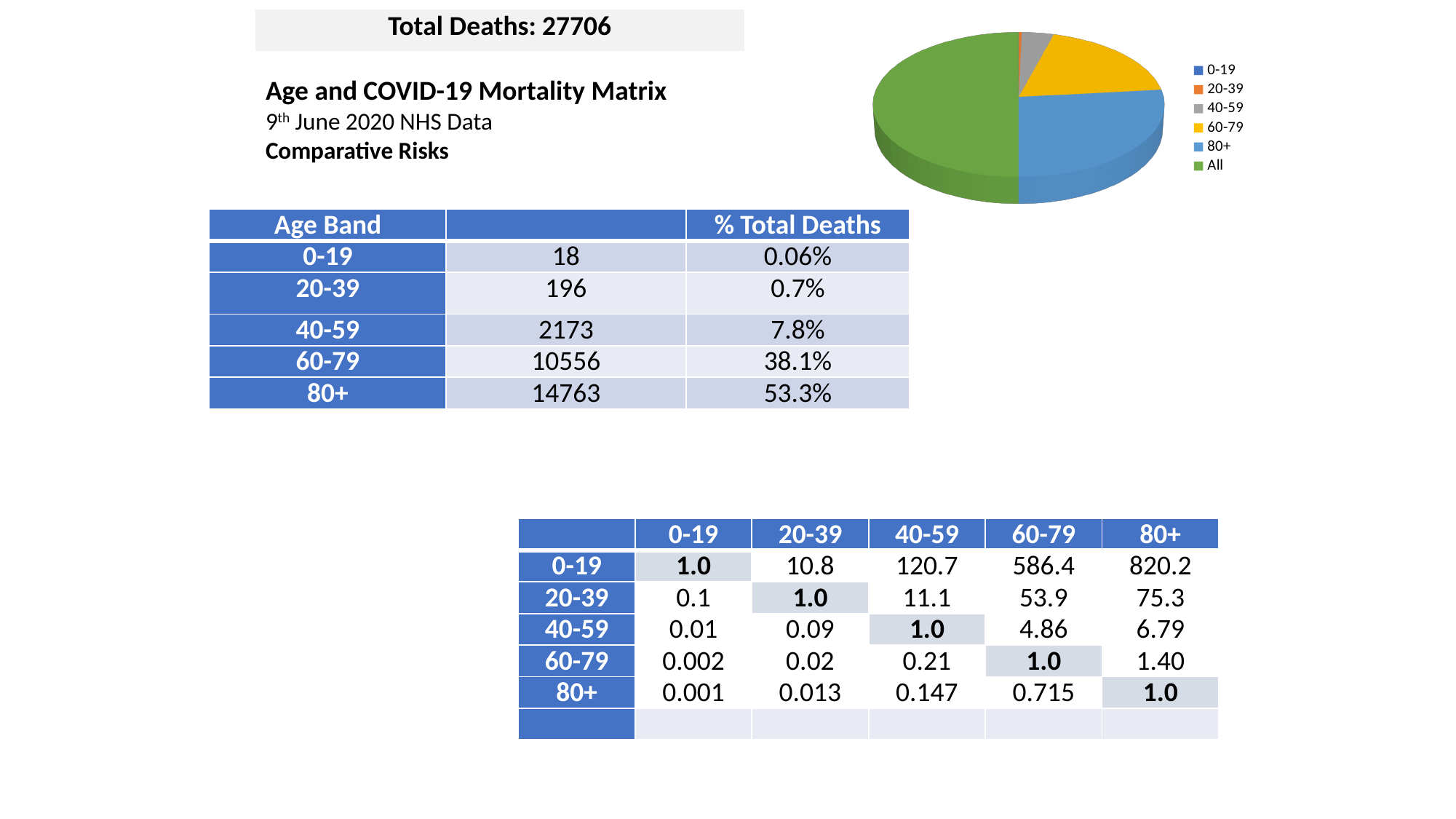
In the pie chart, which slice is larger: 80+ or 60-79? 80+ What colour represents the 80+ category in the pie chart? blue Which category has the largest slice in the pie chart? All How many categories does the pie chart's legend list? 6 In the pie chart, which slice is larger: 40-59 or 20-39? 40-59 In the pie chart, which slice is larger: 60-79 or 40-59? 60-79 What colour represents the All category in the pie chart? green What kind of chart is shown on the slide? pie chart